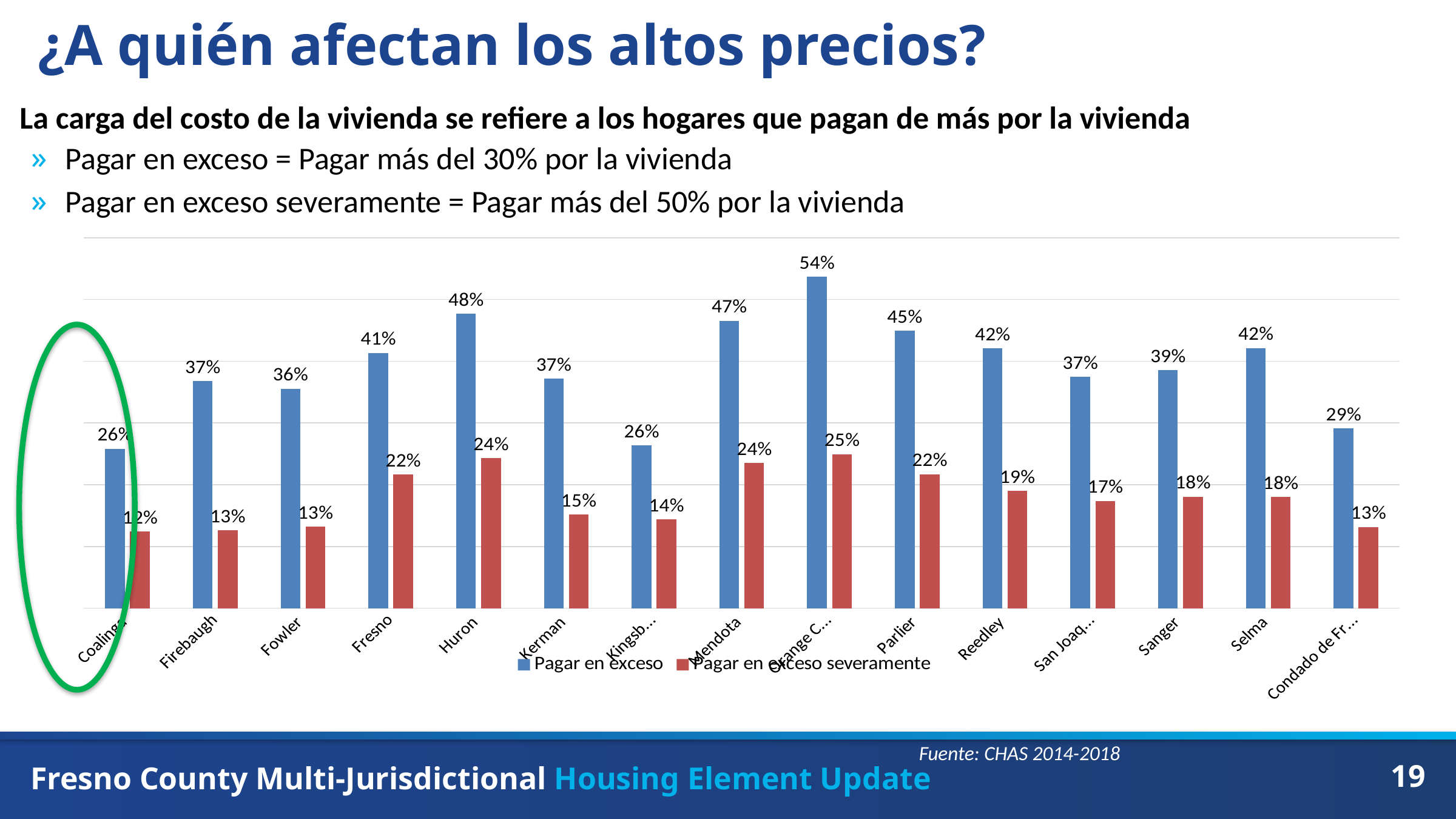
Which is larger: 'Pagar en exceso' for Sanger or for Selma? Selma How many categories (jurisdictions) are shown on the x axis? 15 What type of chart is shown on the slide? bar chart Which category has the lowest value for 'Pagar en exceso severamente'? Coalinga What is the value of 'Pagar en exceso severamente' for Fresno? 22% What is the value of 'Pagar en exceso severamente' for Reedley? 19% What is the value of 'Pagar en exceso' for Huron? 48% How many series does the legend list? 2 What is the difference in 'Pagar en exceso' between Huron and Coalinga? 22% What is the difference between 'Pagar en exceso' and 'Pagar en exceso severamente' for Mendota? 23% What is the value of 'Pagar en exceso' for Parlier? 45% Which series is shown in red in the legend? Pagar en exceso severamente